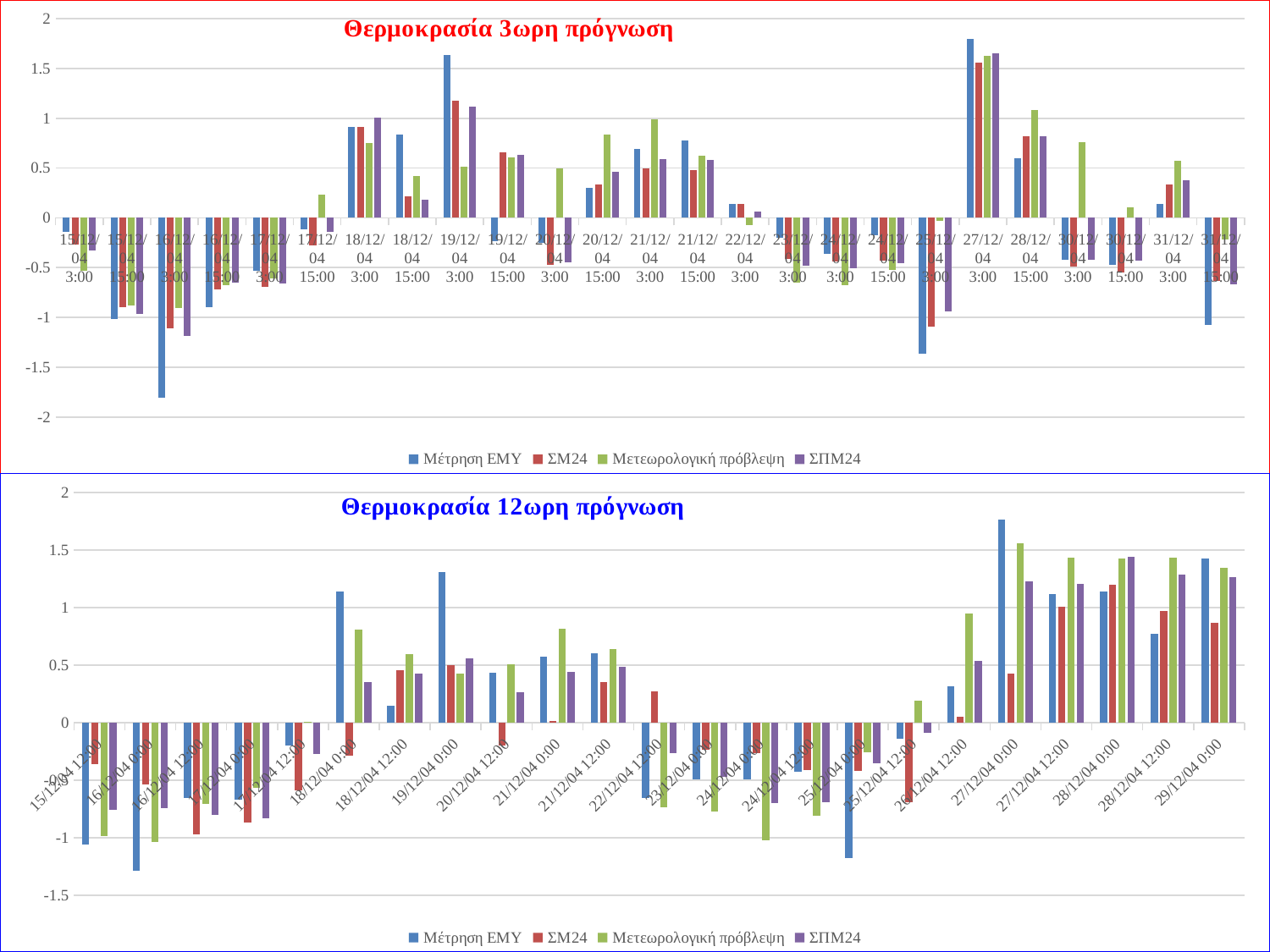
What is the title of the bottom chart on the slide? Θερμοκρασία 12ωρη πρόγνωση In the bottom chart 'Θερμοκρασία 12ωρη πρόγνωση', at which category does the Μέτρηση ΕΜΥ series reach its highest value? 27/12/04 0:00 In the bottom chart 'Θερμοκρασία 12ωρη πρόγνωση', is the Μέτρηση ΕΜΥ value for 16/12/04 0:00 greater or less than -1? less What kind of chart is the top chart titled 'Θερμοκρασία 3ωρη πρόγνωση'? bar chart In the top chart 'Θερμοκρασία 3ωρη πρόγνωση', at which category does the Μέτρηση ΕΜΥ series reach its highest value? 27/12/04 3:00 In the bottom chart 'Θερμοκρασία 12ωρη πρόγνωση', is the Μέτρηση ΕΜΥ value for 18/12/04 0:00 greater or less than 1? greater In the top chart 'Θερμοκρασία 3ωρη πρόγνωση', is the Μέτρηση ΕΜΥ value for 27/12/04 3:00 greater or less than 1.5? greater How many series does the legend of the bottom chart 'Θερμοκρασία 12ωρη πρόγνωση' list? 4 In the top chart 'Θερμοκρασία 3ωρη πρόγνωση', at which category does the Μέτρηση ΕΜΥ series reach its lowest value? 16/12/04 3:00 In the bottom chart 'Θερμοκρασία 12ωρη πρόγνωση', at 27/12/04 0:00, which is larger: Μέτρηση ΕΜΥ or ΣΜ24? Μέτρηση ΕΜΥ